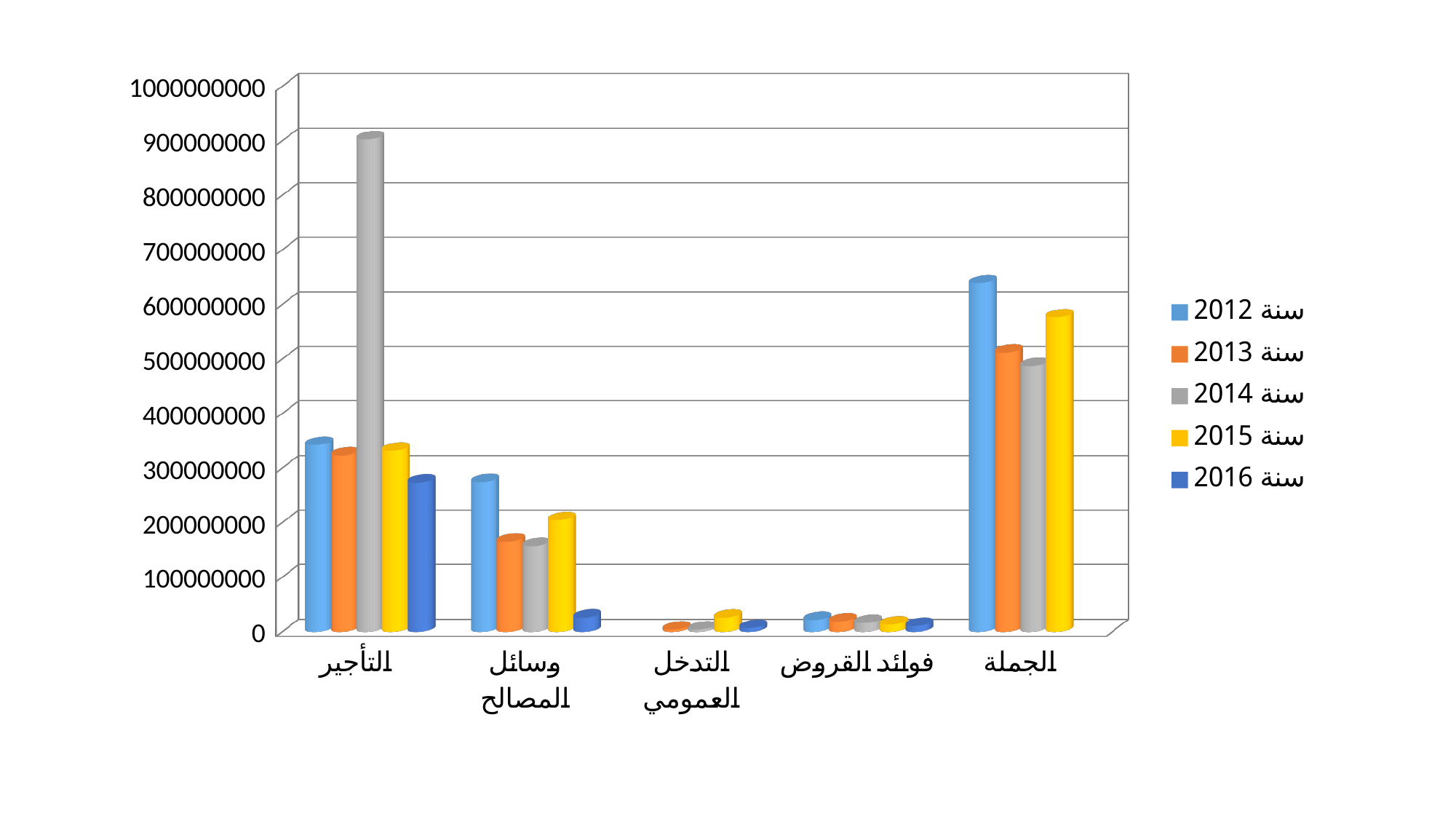
How many categories are shown on the x axis of the chart? 5 Is the value for سنة 2014 in التأجير greater or less than 800000000? greater What is the highest value shown on the vertical axis? 1000000000 What kind of chart is shown on the slide? bar chart Is the value for سنة 2015 in الجملة greater or less than 500000000? greater Which category contains the tallest bar in the chart? التأجير Is the value for سنة 2012 in وسائل المصالح greater or less than 300000000? less In the الجملة category, which is larger: the bar for سنة 2012 or the bar for سنة 2015? سنة 2012 How many series does the legend list? 5 Which series has the highest bar in the الجملة category? سنة 2012 Which series has the lowest bar in the التأجير category? سنة 2016 Which series has the highest bar in the التأجير category? سنة 2014